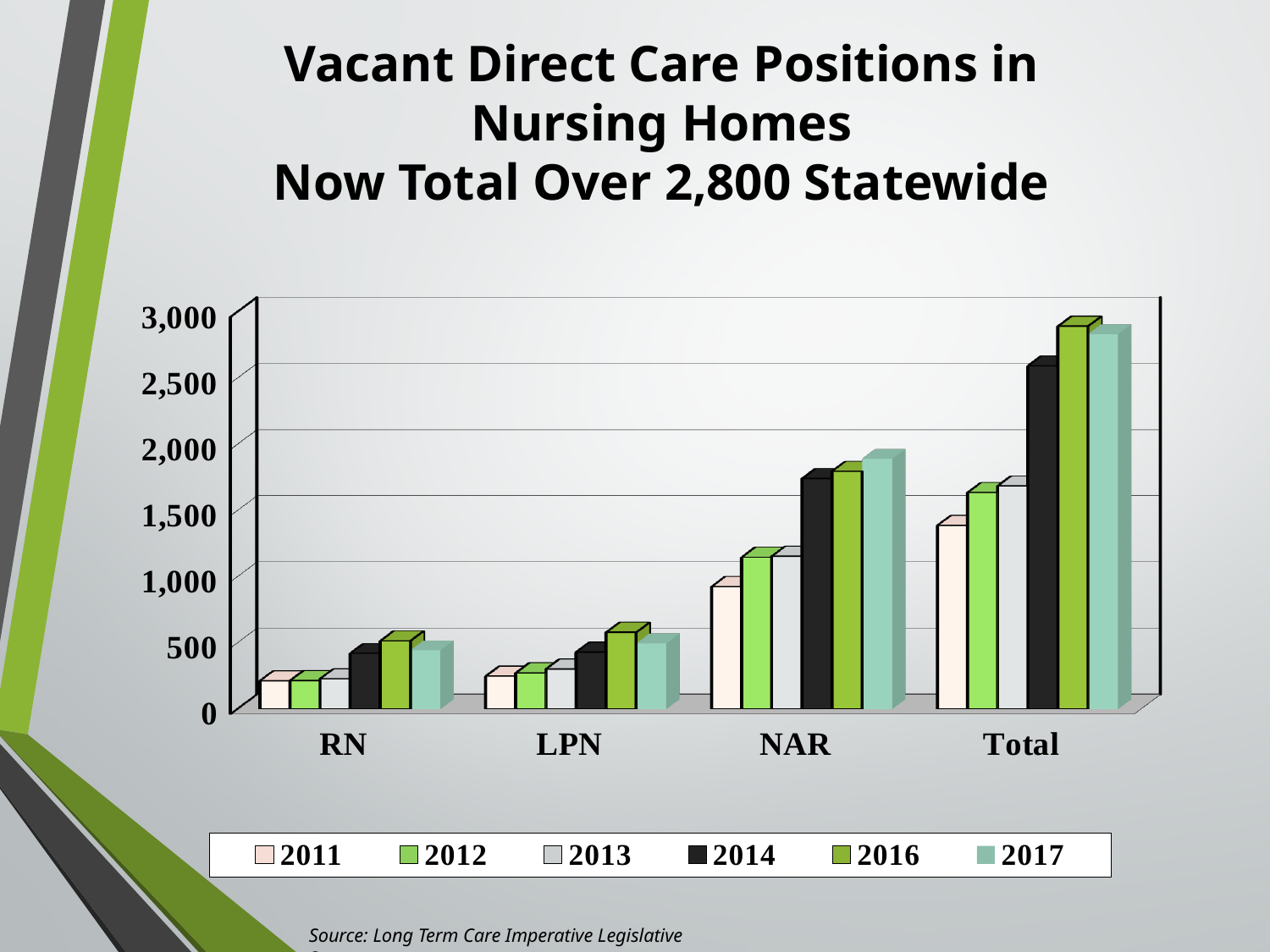
Which is larger, the 2017 value for NAR or the 2017 value for LPN? NAR How many categories are shown on the x axis of the chart? 4 Is the 2014 value for NAR greater or less than 1,500? greater Which category has the highest 2017 value? Total What kind of chart is shown on the slide? Bar chart Is the 2011 value for Total greater or less than 1,500? less Is the 2016 value for Total greater or less than 2,500? greater Do the Total values generally rise or fall from 2011 to 2016? rise How many series does the chart's legend list? 6 Which category has the lowest 2011 value? RN